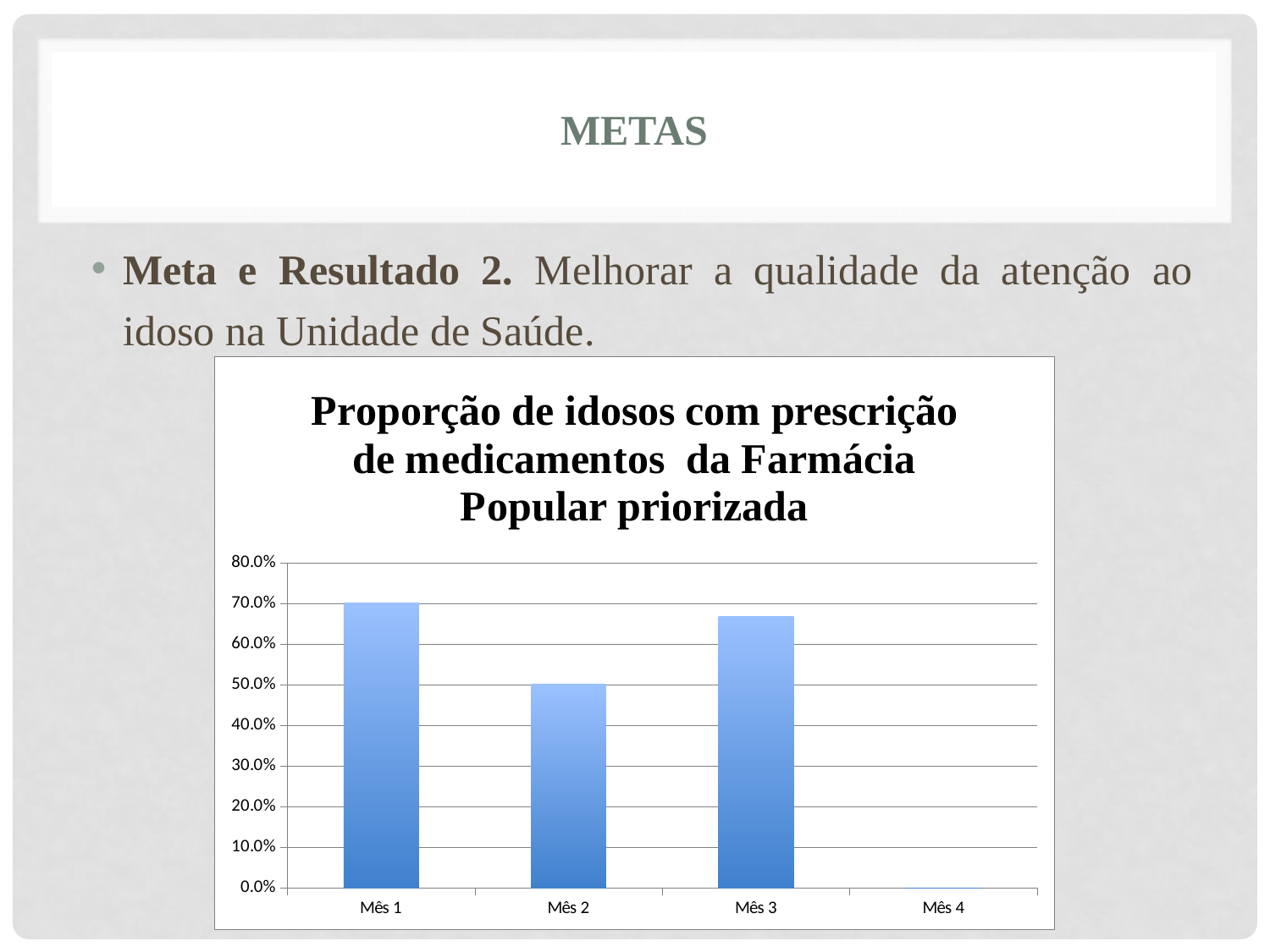
Is the value for Mês 2 greater or less than 60.0%? less Which month has the highest bar in the chart? Mês 1 Which is larger, the value for Mês 1 or the value for Mês 2? Mês 1 Is the value for Mês 1 greater or less than 60.0%? greater Which month on the x axis has no bar shown? Mês 4 Is the value for Mês 3 greater or less than 60.0%? greater Which is larger, the value for Mês 3 or the value for Mês 2? Mês 3 How many categories are shown on the x axis of the chart? 4 Among the months with a visible bar, which has the lowest value? Mês 2 Does the value rise or fall from Mês 1 to Mês 2? fall What kind of chart is shown on the slide? bar chart